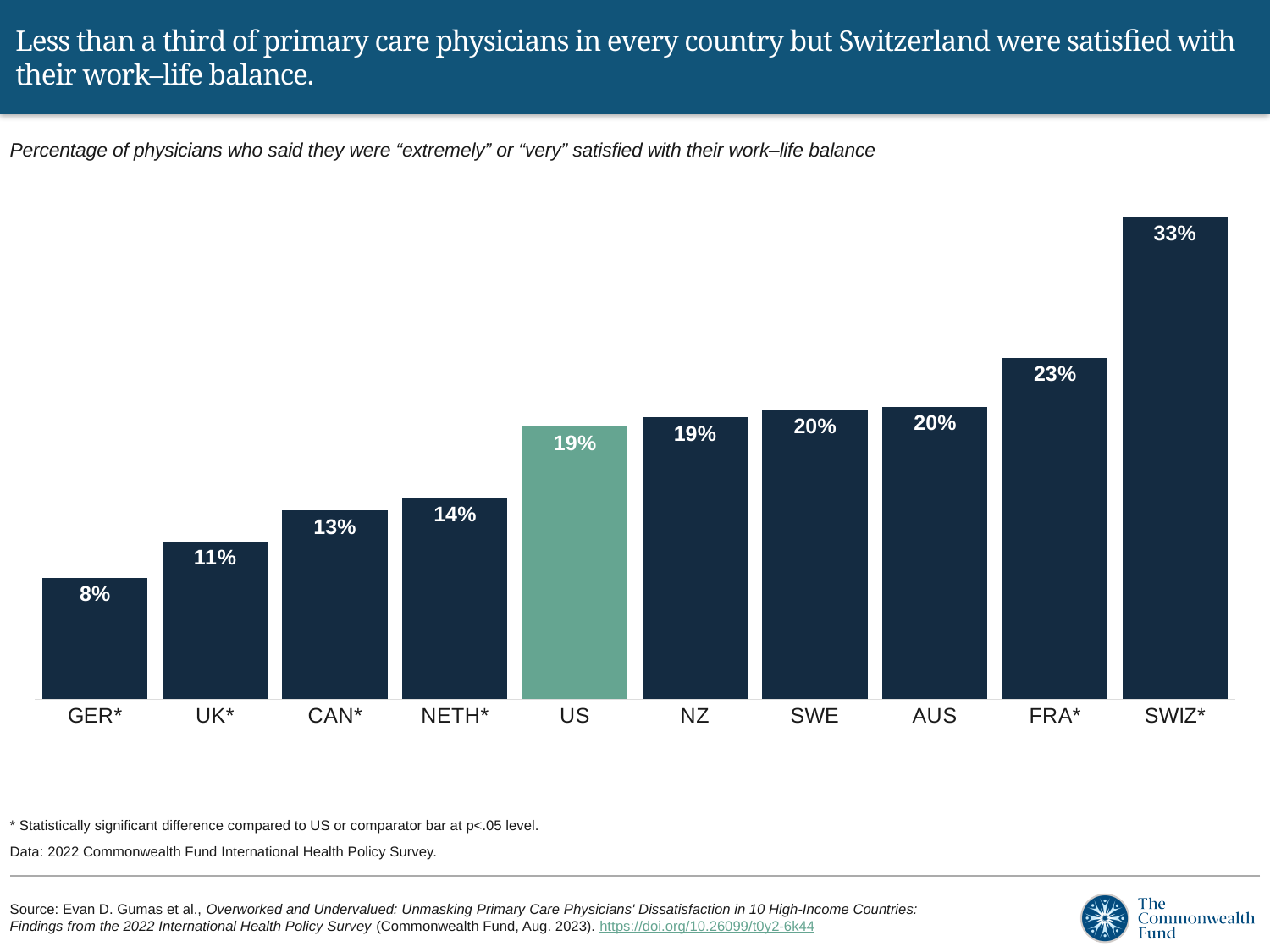
What is the value shown for FRA*? 23% How many countries are shown in the chart? 10 What is the difference between the values for FRA* and the US? 4 percentage points What is the value shown for GER*? 8% Which country has the highest percentage of physicians satisfied with their work–life balance? SWIZ* What percentage of physicians in the US said they were satisfied with their work–life balance? 19% What is the value shown for SWIZ*? 33% What is the difference between the values for SWIZ* and GER*? 25 percentage points What kind of chart is shown on the slide? Bar chart Which country has the lowest percentage of physicians satisfied with their work–life balance? GER* Do the values rise or fall moving from left to right along the x axis? Rise Which has a higher value, UK* or NETH*? NETH*